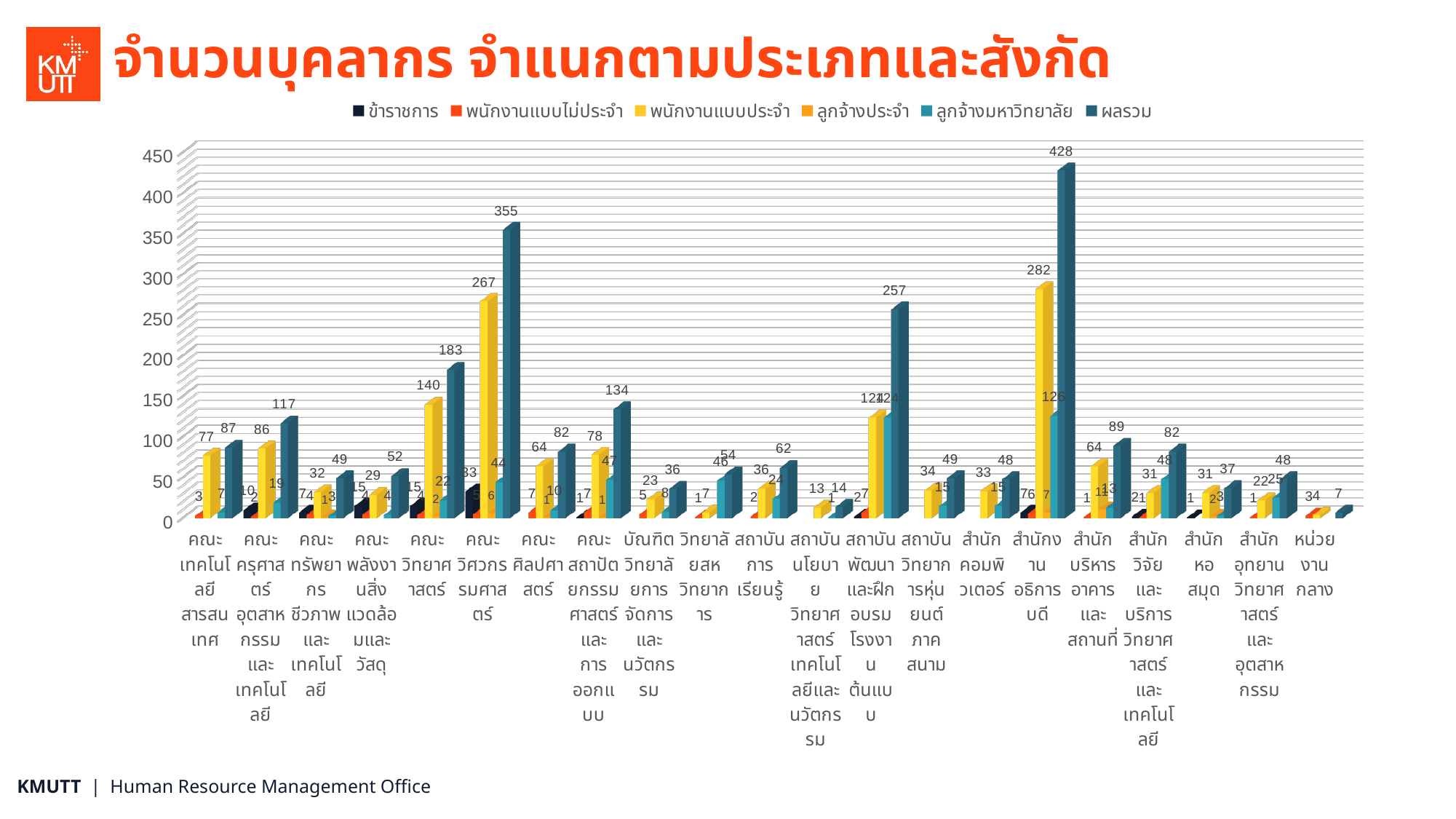
What is the title of the chart? จำนวนบุคลากร จำแนกตามประเภทและสังกัด How many categories (units) are shown along the x axis? 21 What is the พนักงานแบบประจำ value for คณะวิทยาศาสตร์? 140 What is the พนักงานแบบประจำ value for สำนักงานอธิการบดี? 282 What kind of chart is shown on the slide? bar chart What is the difference between the ผลรวม values of สำนักงานอธิการบดี and คณะวิศวกรรมศาสตร์? 73 Which has the larger ผลรวม value: คณะครุศาสตร์อุตสาหกรรมและเทคโนโลยี or คณะเทคโนโลยีสารสนเทศ? คณะครุศาสตร์อุตสาหกรรมและเทคโนโลยี What is the ผลรวม value for สถาบันพัฒนาและฝึกอบรมโรงงานต้นแบบ? 257 Which category has the highest ผลรวม value? สำนักงานอธิการบดี How many series does the legend list? 6 What is the ผลรวม value for คณะวิศวกรรมศาสตร์? 355 Which category has the lowest ผลรวม value? หน่วยงานกลาง